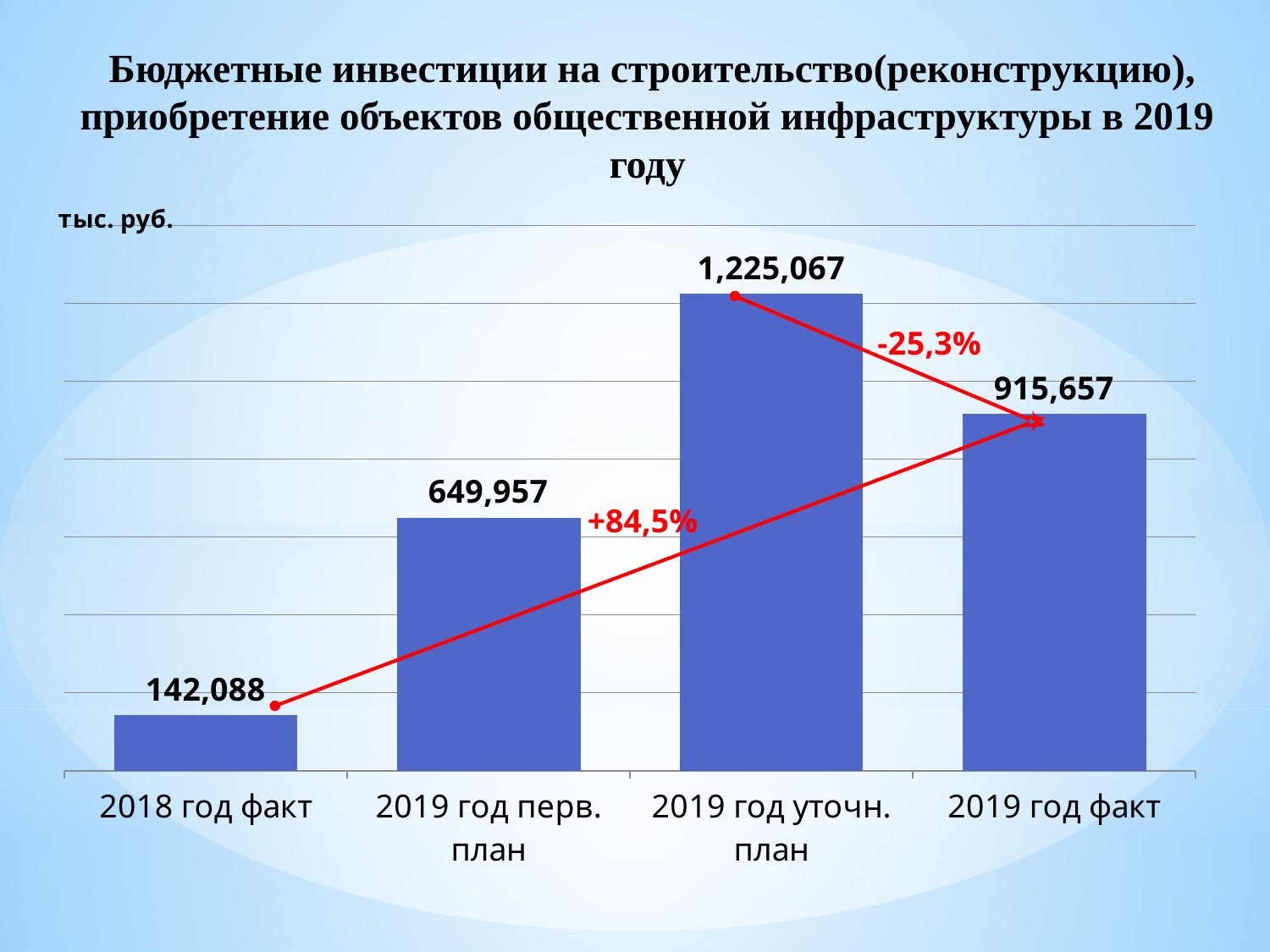
How many categories are shown on the x axis? 4 What is the value for "2018 год факт"? 142,088 What kind of chart is this? bar chart Which is larger, the value for "2019 год перв. план" or the value for "2019 год факт"? 2019 год факт What is the difference between the values for "2019 год перв. план" and "2018 год факт"? 507,869 What is the value for "2019 год факт"? 915,657 What is the difference between the values for "2019 год уточн. план" and "2019 год факт"? 309,410 What is the value for "2019 год уточн. план"? 1,225,067 Which category has the highest value? 2019 год уточн. план What percentage change is labelled on the red line between "2019 год уточн. план" and "2019 год факт"? -25,3% Which category has the lowest value? 2018 год факт What is the value for "2019 год перв. план"? 649,957